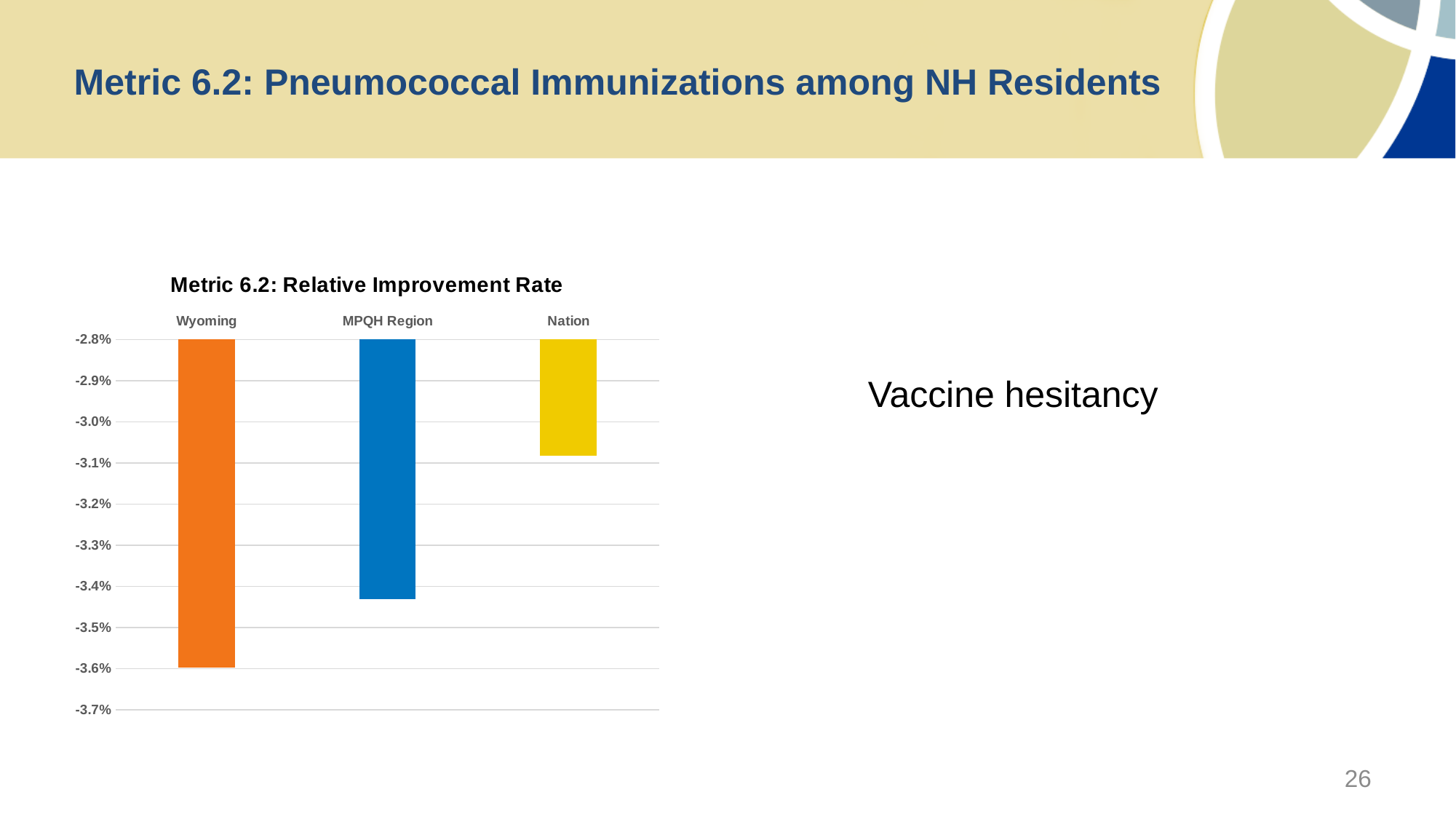
Which category has the highest (least negative) relative improvement rate? Nation Which has the larger value, Wyoming or Nation? Nation Which category has the lowest (most negative) relative improvement rate? Wyoming Is the value for Nation greater or less than -3.0%? less What kind of chart is shown on the slide? Bar chart Is the value for Nation greater or less than -3.2%? greater What is the relative improvement rate for Wyoming? -3.6% How many categories are shown in the chart? 3 What colour is the bar for MPQH Region? Blue Is the value for MPQH Region greater or less than -3.3%? less What is the title of the chart? Metric 6.2: Relative Improvement Rate Which has the larger value, MPQH Region or Wyoming? MPQH Region